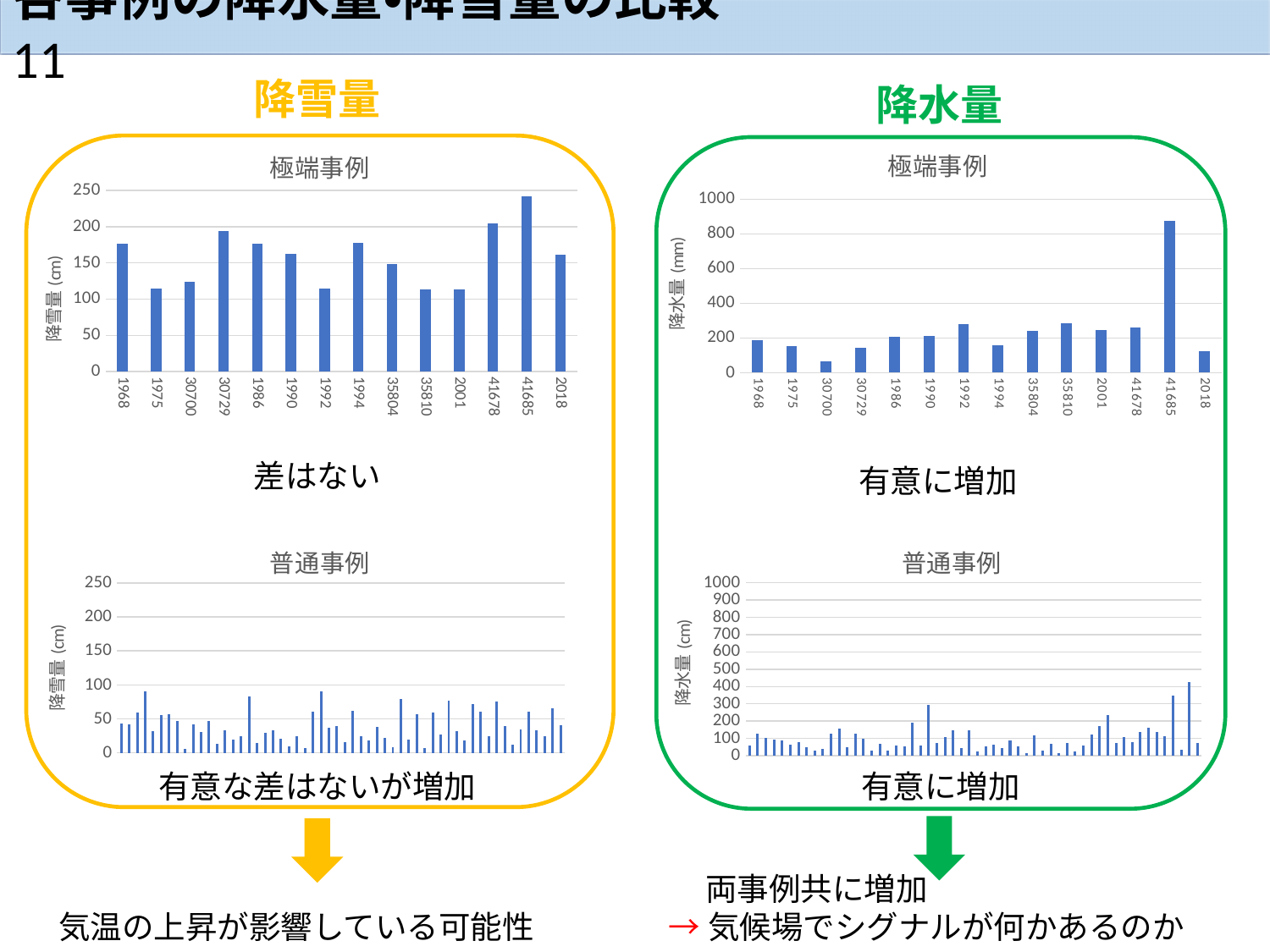
What kind of chart is the 極端事例 chart under 降雪量 on the left of the slide? bar chart In the 極端事例 chart under 降雪量 (top left), is the value for 41685 greater or less than 200? greater In the 極端事例 chart under 降水量 (top right), which category has the highest value? 41685 In the 極端事例 chart under 降雪量 (top left), which is larger, the value for 41678 or the value for 1975? 41678 In the 極端事例 chart under 降雪量 (top left), which category has the highest value? 41685 In the 極端事例 chart under 降水量 (top right), is the value for 2018 greater or less than 200? less What is the y-axis title of the 極端事例 chart under 降水量 (top right)? 降水量 (mm) In the 極端事例 chart under 降雪量 (top left), is the value for 30700 greater or less than 150? less In the 極端事例 chart under 降雪量 (top left), how many categories are shown on the x axis? 14 What is the title of the lower chart on the left side of the slide, under 降雪量? 普通事例 In the 極端事例 chart under 降水量 (top right), which category has the lowest value? 30700